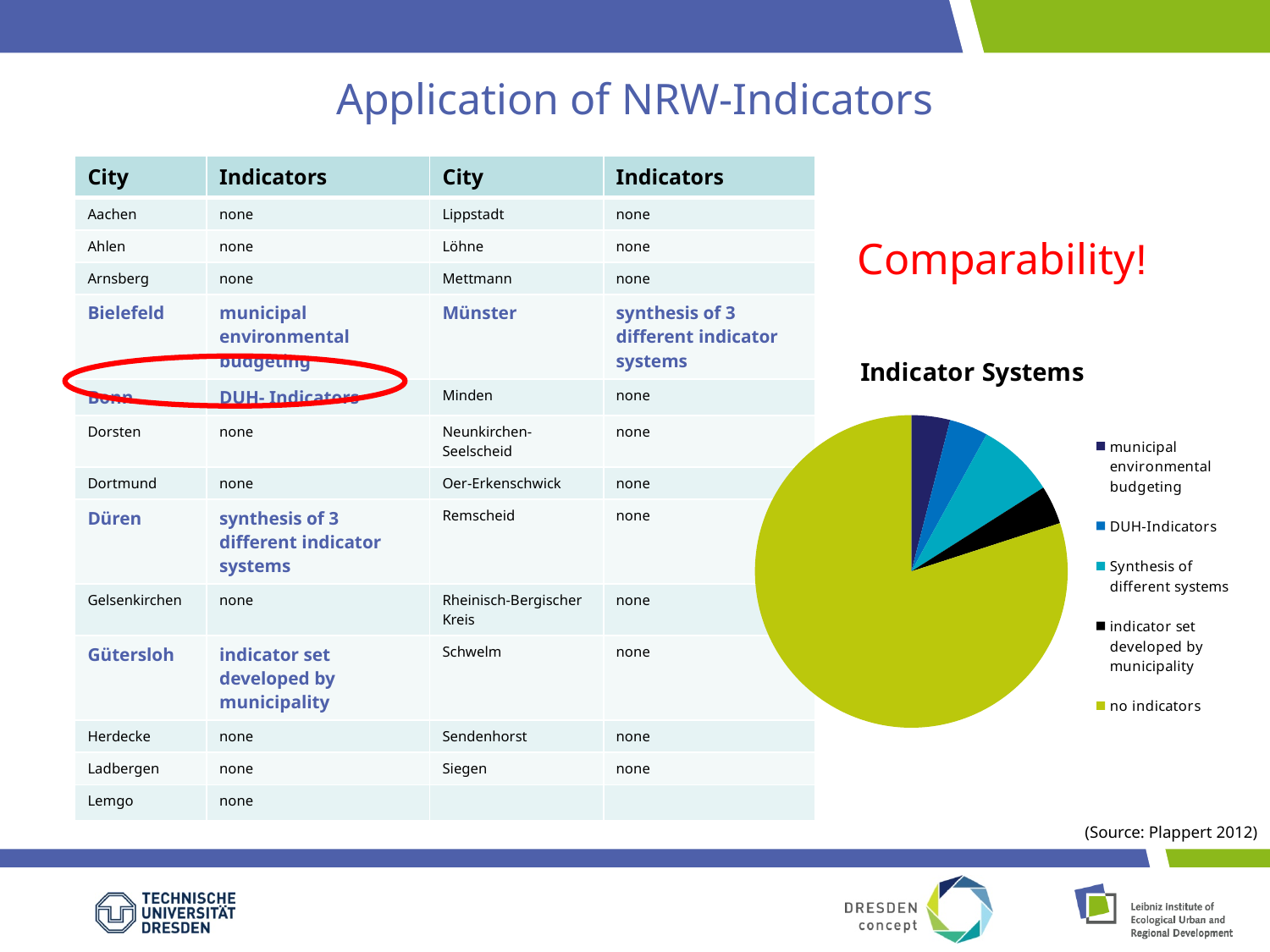
In the Indicator Systems pie chart, which slice is larger: "no indicators" or "Synthesis of different systems"? no indicators What colour is the "no indicators" slice in the Indicator Systems pie chart? yellow-green What is the title of the chart on the slide? Indicator Systems In the Indicator Systems pie chart, which slice is larger: "Synthesis of different systems" or "DUH-Indicators"? Synthesis of different systems What kind of chart is shown on the slide? pie chart How many slices does the Indicator Systems pie chart have? 5 Which category has the largest slice in the Indicator Systems pie chart? no indicators How many entries does the legend of the Indicator Systems chart list? 5